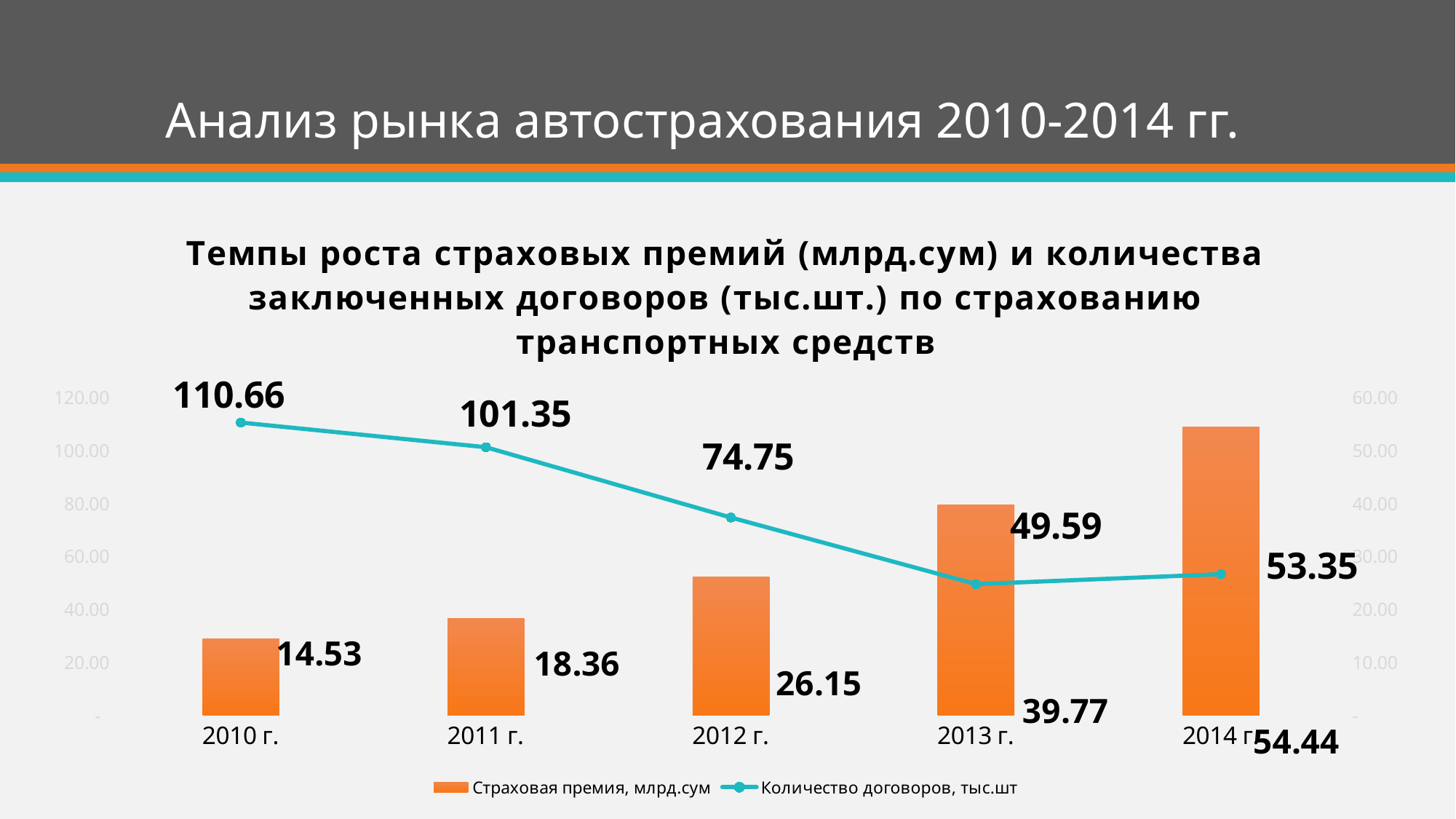
What is the difference between the insurance premium in 2014 г. and in 2013 г.? 14.67 In which year is the number of contracts (Количество договоров, тыс.шт) highest? 2010 г. What is the value of the insurance premium (Страховая премия, млрд.сум) for 2010 г.? 14.53 What is the number of contracts (Количество договоров, тыс.шт) for 2012 г.? 74.75 In which year is the insurance premium (Страховая премия, млрд.сум) lowest? 2010 г. Does the insurance premium (Страховая премия, млрд.сум) rise or fall from 2010 г. to 2014 г.? rise How many series does the chart legend list? 2 Which is larger: the number of contracts in 2013 г. or in 2014 г.? 2014 г. What kind of chart is used for the series Страховая премия, млрд.сум? bar chart How many years are shown on the x axis of the chart? 5 What colour is the line for Количество договоров, тыс.шт? teal What is the value of the insurance premium (Страховая премия, млрд.сум) for 2014 г.? 54.44